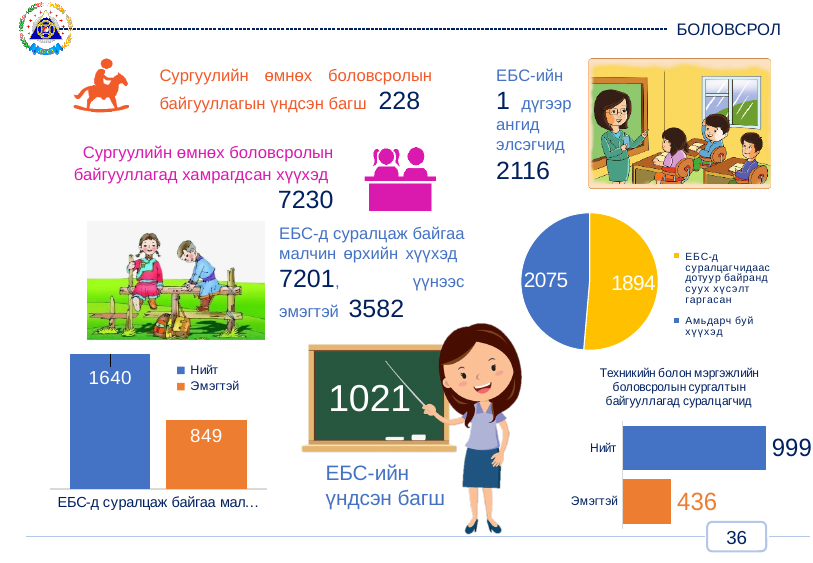
How many entries does the legend of the pie chart on the right of the slide list? 2 In the pie chart on the right of the slide, which slice is larger, the blue one (Амьдарч буй хүүхэд) or the yellow one? the blue one (Амьдарч буй хүүхэд) In the pie chart on the right of the slide, what is the difference between the two slice values? 181 In the bar chart at the bottom left of the slide, what is the difference between 'Нийт' and 'Эмэгтэй'? 791 What kind of chart is shown at the bottom left of the slide? bar chart In the pie chart on the right of the slide, what is the value of the blue slice labelled 'Амьдарч буй хүүхэд'? 2075 In the pie chart on the right of the slide, what is the value of the yellow slice? 1894 In the bar chart at the bottom left of the slide, what is the value for 'Нийт'? 1640 In the bar chart at the bottom right of the slide (Техникийн болон мэргэжлийн боловсролын сургалтын байгууллагад суралцагчид), what is the value for 'Нийт'? 999 In the bar chart at the bottom right of the slide, what is the difference between 'Нийт' and 'Эмэгтэй'? 563 In the bar chart at the bottom right of the slide, what is the value for 'Эмэгтэй'? 436 In the bar chart at the bottom left of the slide, what is the value for 'Эмэгтэй'? 849